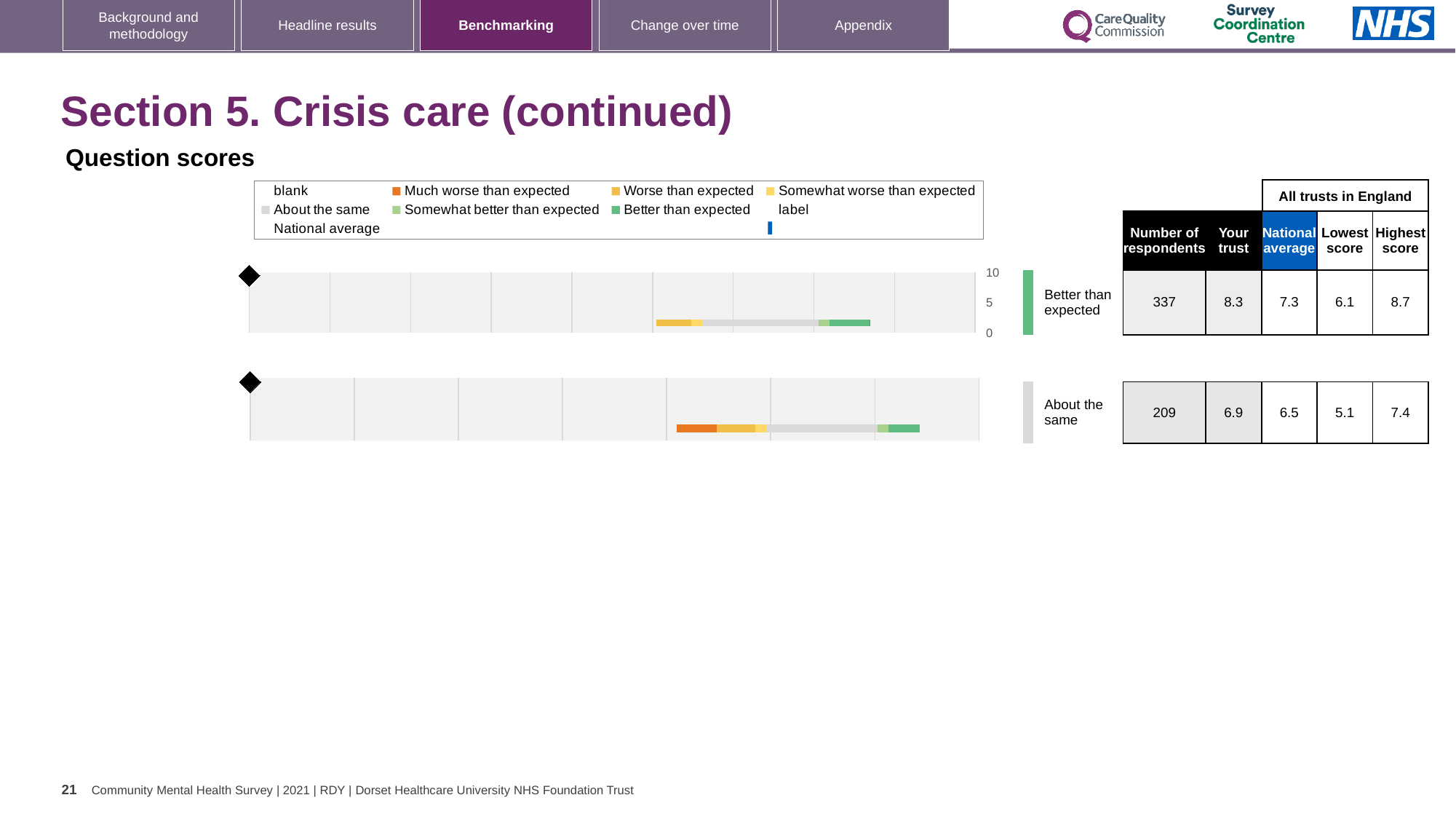
What kind of chart is used to show the question scores on this slide? bar chart For the question rated 'About the same', what is the national average score? 6.5 How many respondents are listed for the question rated 'Better than expected'? 337 For the question rated 'Better than expected', how much higher is the 'Your trust' score than the national average? 1.0 For the question rated 'About the same', what is the difference between the highest score and the lowest score across all trusts in England? 2.3 How many question score charts (rows) are shown on the slide? 2 Which question has the larger 'Your trust' score: the one rated 'Better than expected' or the one rated 'About the same'? Better than expected What is the maximum value shown on the score axis of the charts? 10 What is the highest score across all trusts in England for the question rated 'Better than expected'? 8.7 What is the lowest score across all trusts in England for the question rated 'About the same'? 5.1 For the question rated 'Better than expected', what is the 'Your trust' score? 8.3 In the legend, what colour represents 'Much worse than expected'? orange